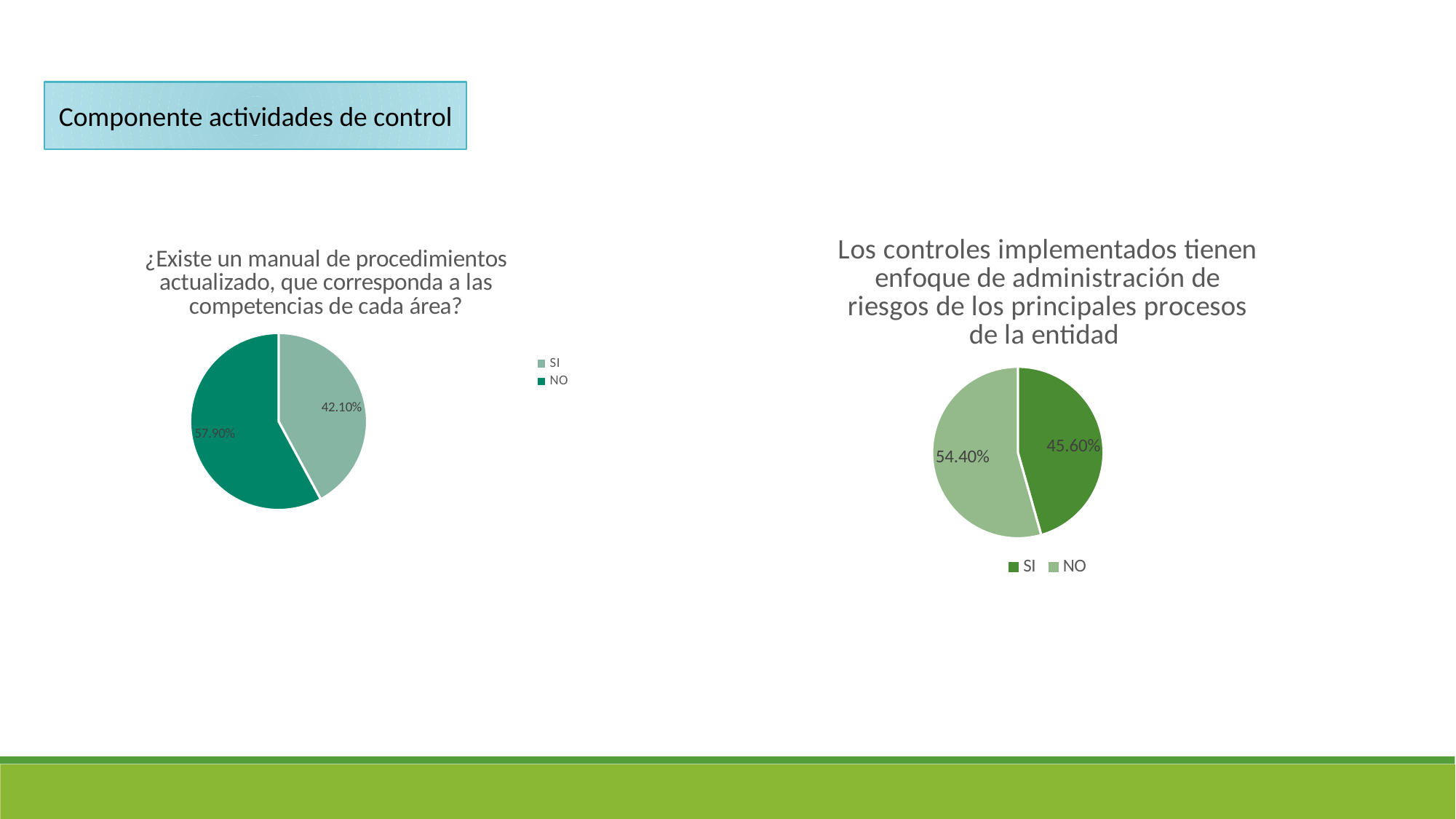
In the right chart (Los controles implementados tienen enfoque de administración de riesgos...), which response has the smaller share? SI What type of chart is used on the left of the slide? Pie chart How many slices does the right chart (Los controles implementados tienen enfoque de administración de riesgos...) have? 2 What entries does the legend of the left chart (¿Existe un manual de procedimientos actualizado...?) list? SI, NO In the left chart (¿Existe un manual de procedimientos actualizado...?), what is the difference in percentage points between NO and SI? 15.80% In the right chart (Los controles implementados tienen enfoque de administración de riesgos...), what share of responses is SI? 45.60% In the left chart (¿Existe un manual de procedimientos actualizado...?), what share of responses is NO? 57.90% In the right chart (Los controles implementados tienen enfoque de administración de riesgos...), what is the difference in percentage points between NO and SI? 8.80% In the left chart (¿Existe un manual de procedimientos actualizado...?), which response has the larger share? NO In the left chart (¿Existe un manual de procedimientos actualizado...?), what share of responses is SI? 42.10% Is the SI share larger in the left chart or in the right chart? Right chart In the right chart (Los controles implementados tienen enfoque de administración de riesgos...), what share of responses is NO? 54.40%